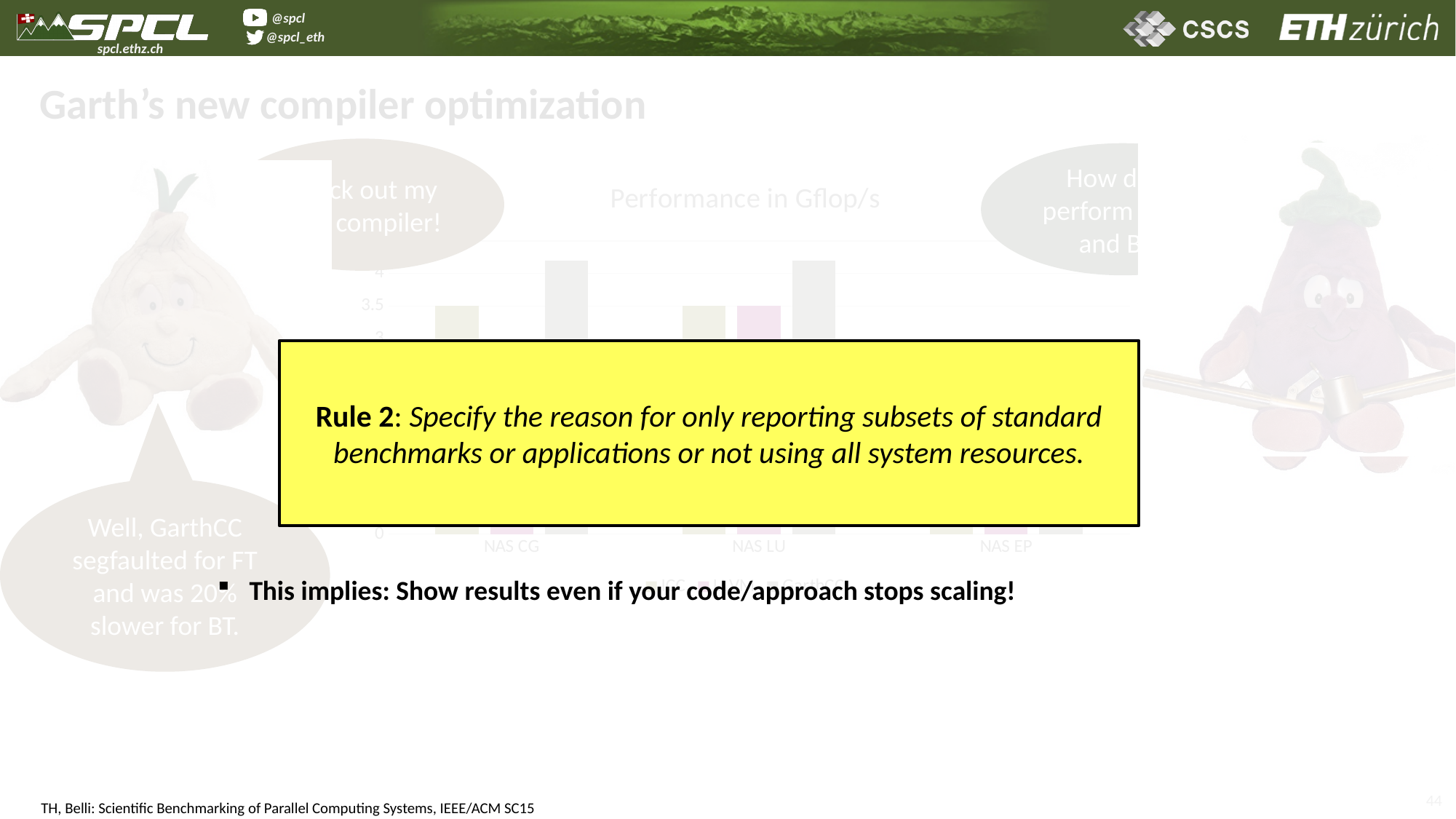
How many benchmark categories are shown on the x axis of the chart? 3 Which benchmark categories are listed on the x axis of the chart? NAS CG, NAS LU, NAS EP Is the tallest bar for NAS CG greater or less than 3.5? greater Is the tallest bar for NAS LU greater or less than 3.5? greater What kind of chart is shown on the slide? bar chart What is the title of the chart? Performance in Gflop/s